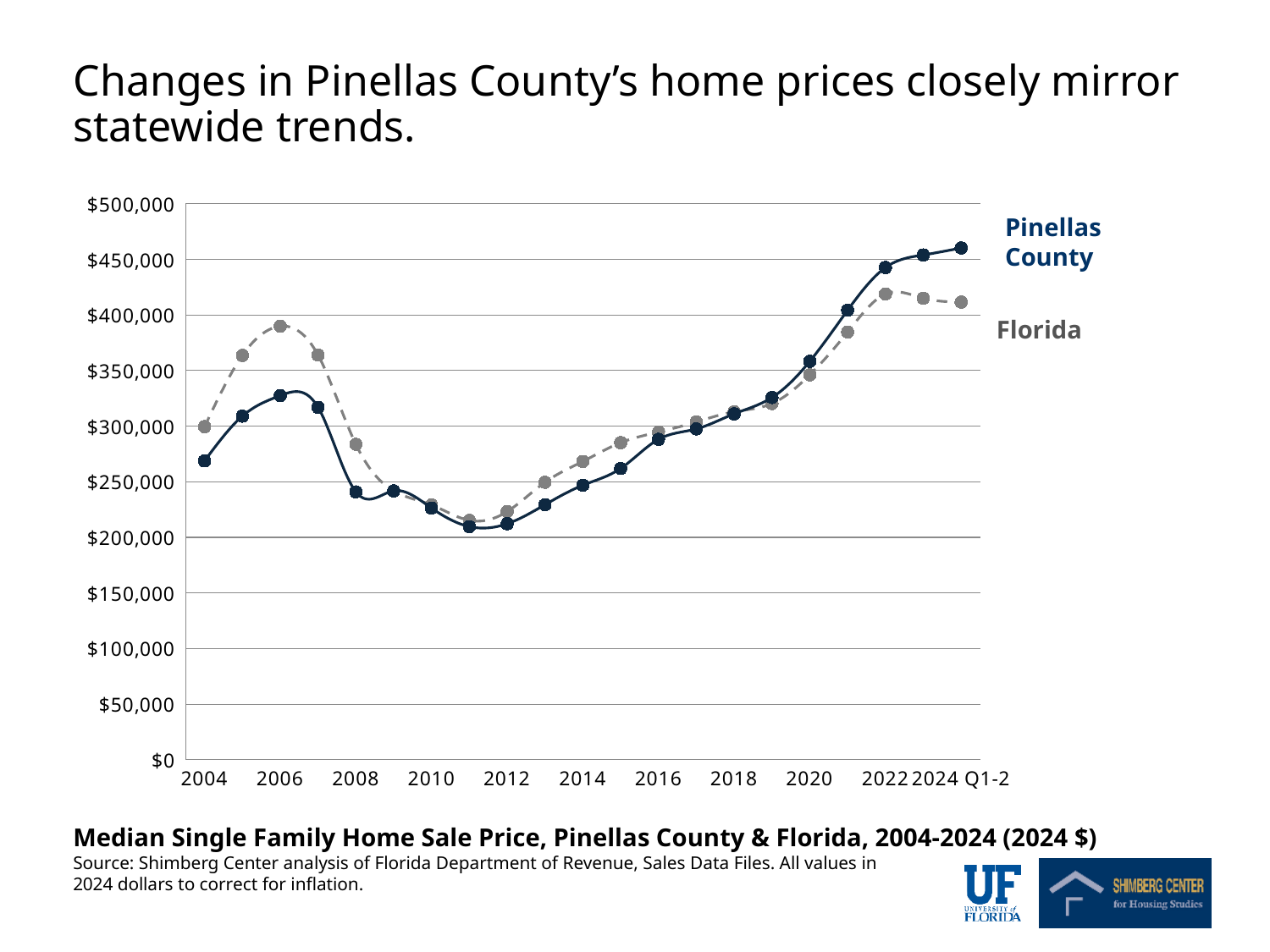
How many series are plotted on the chart? 2 In 2006, which series has the higher value, Pinellas County or Florida? Florida What is the title of the chart? Median Single Family Home Sale Price, Pinellas County & Florida, 2004-2024 (2024 $) In which year does the Pinellas County series reach its highest value? 2024 Q1-2 Which two series are plotted on the chart? Pinellas County and Florida Is the Pinellas County value for 2004 greater or less than $250,000? greater Is the Florida value for 2024 Q1-2 greater or less than $400,000? greater In 2024 Q1-2, which series has the higher value, Pinellas County or Florida? Pinellas County Is the Florida value for 2006 greater or less than $350,000? greater What kind of chart is shown on the slide? line chart Do Pinellas County home prices rise or fall between 2012 and 2022? rise